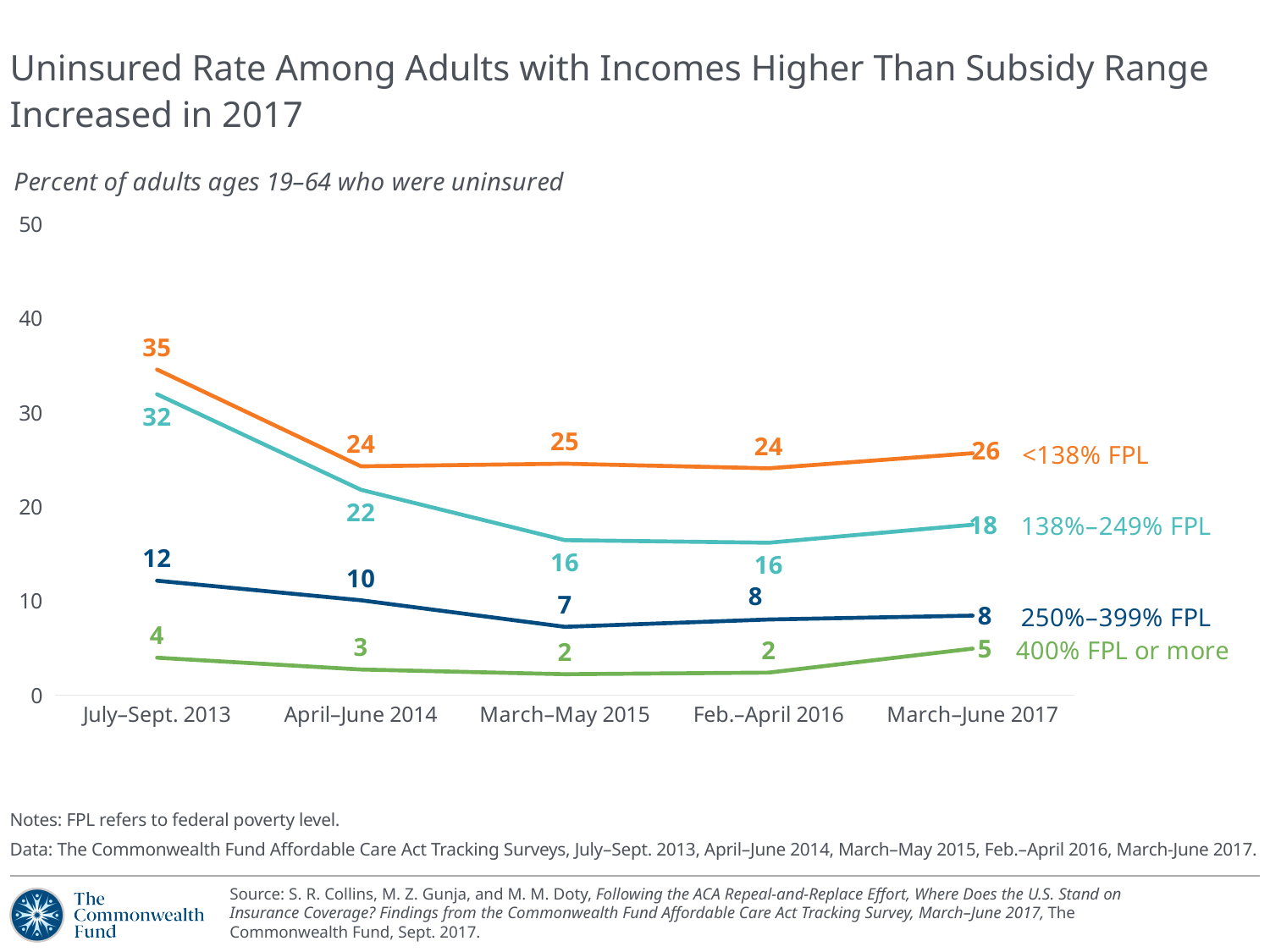
How many income groups (lines) are plotted on the chart? 4 Did the uninsured rate for the <138% FPL group rise or fall from July–Sept. 2013 to April–June 2014? Fall In which survey period was the uninsured rate for the 250%–399% FPL group lowest? March–May 2015 How many survey periods are shown on the x axis? 5 What is the difference between the uninsured rates of the <138% FPL group and the 400% FPL or more group in March–June 2017? 21 Which was larger in Feb.–April 2016: the uninsured rate for the 250%–399% FPL group or the 400% FPL or more group? 250%–399% FPL Which income group had the highest uninsured rate in March–June 2017? <138% FPL By how much did the uninsured rate for the 138%–249% FPL group fall from July–Sept. 2013 to April–June 2014? 10 What was the uninsured rate for the 400% FPL or more group in March–June 2017? 5 What was the uninsured rate for adults with incomes below 138% FPL in July–Sept. 2013? 35 What was the uninsured rate for the 138%–249% FPL group in March–May 2015? 16 What kind of chart is shown on the slide? Line chart